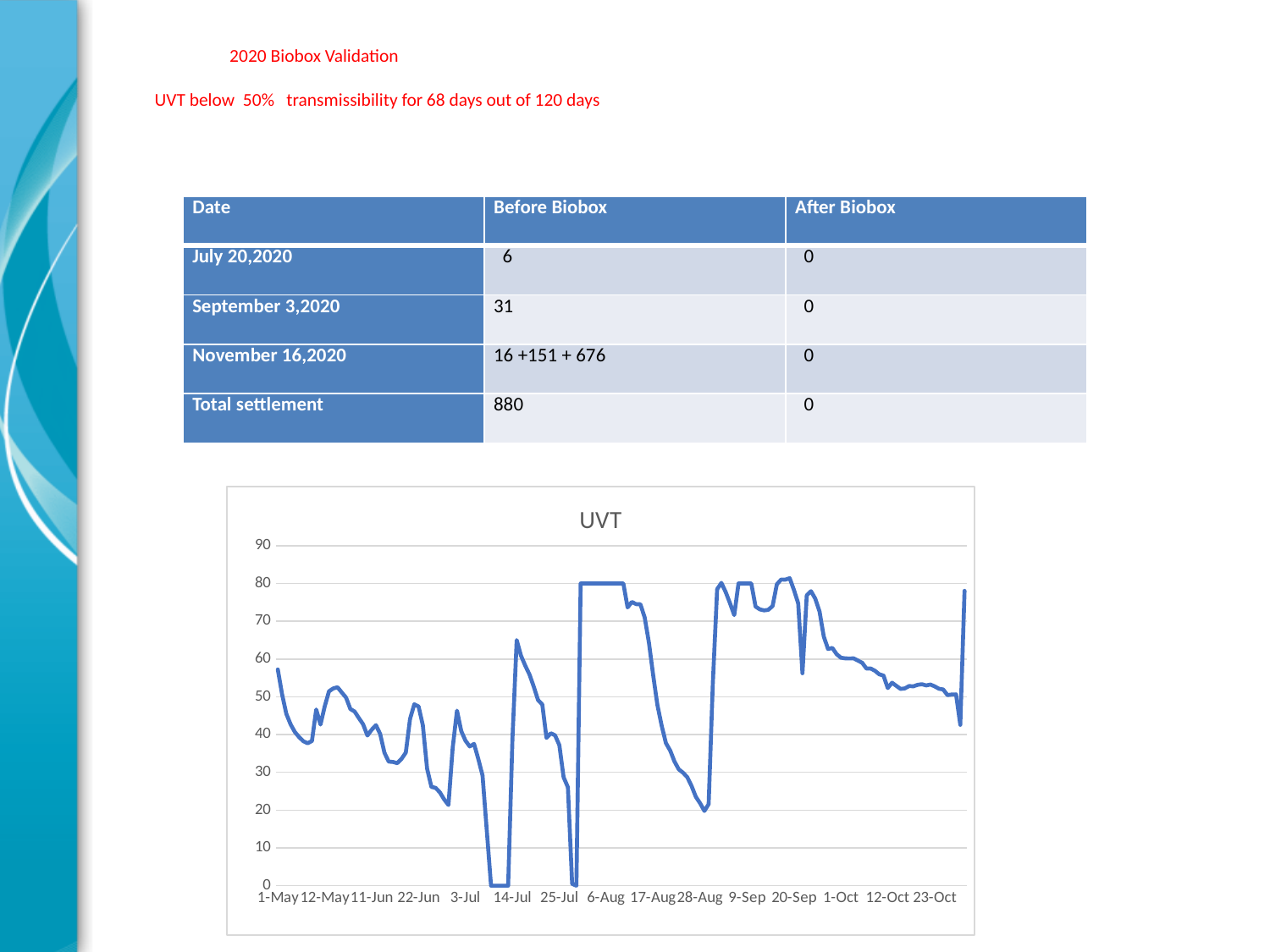
Between 6-Aug and 28-Aug, do the UVT values rise or fall? fall How many date labels are shown along the x axis of the UVT chart? 15 Is the UVT value at 6-Aug greater or less than 70? greater Is the UVT value at 28-Aug greater or less than 30? less What kind of chart is shown on the slide? line chart Does the UVT line ever rise above 90? No What is the title of the chart? UVT Between 20-Sep and 12-Oct, do the UVT values generally rise or fall? fall What is the highest value shown on the chart's vertical axis? 90